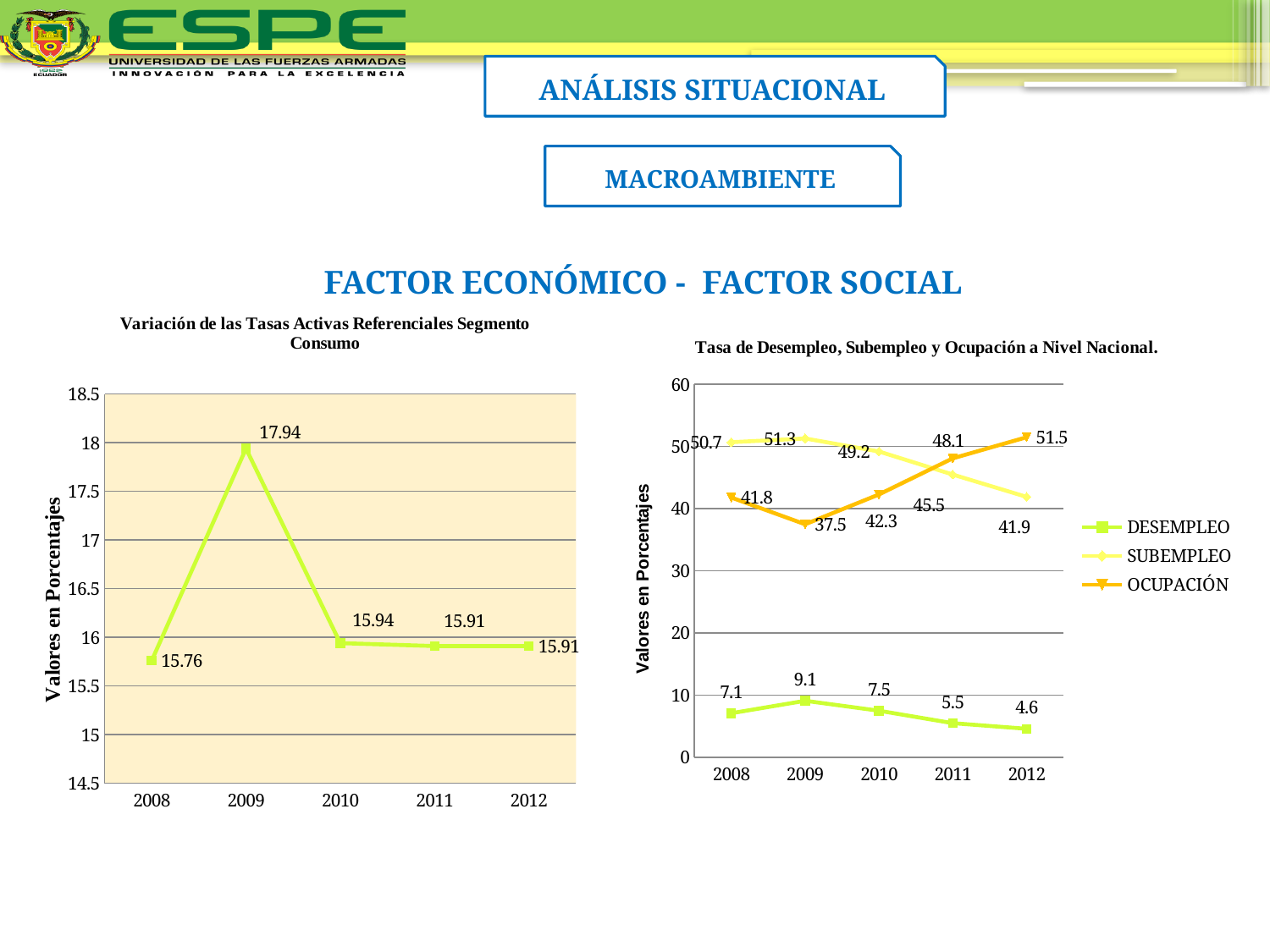
In the right chart (Tasa de Desempleo, Subempleo y Ocupación a Nivel Nacional), what is the difference between the SUBEMPLEO and OCUPACIÓN values in 2009? 13.8 What kind of chart is the left chart (Variación de las Tasas Activas Referenciales Segmento Consumo)? Line chart In the right chart (Tasa de Desempleo, Subempleo y Ocupación a Nivel Nacional), how many series does the legend list? 3 In the right chart (Tasa de Desempleo, Subempleo y Ocupación a Nivel Nacional), what is the OCUPACIÓN value for 2012? 51.5 In the right chart (Tasa de Desempleo, Subempleo y Ocupación a Nivel Nacional), does the OCUPACIÓN series rise or fall from 2009 to 2012? Rise In the left chart (Variación de las Tasas Activas Referenciales Segmento Consumo), how many years are plotted on the x axis? 5 In the right chart (Tasa de Desempleo, Subempleo y Ocupación a Nivel Nacional), which year has the lowest SUBEMPLEO value? 2012 In the left chart (Variación de las Tasas Activas Referenciales Segmento Consumo), which year has the lowest value? 2008 In the left chart (Variación de las Tasas Activas Referenciales Segmento Consumo), what is the difference between the 2009 value and the 2008 value? 2.18 In the right chart (Tasa de Desempleo, Subempleo y Ocupación a Nivel Nacional), which is larger in 2010: SUBEMPLEO or OCUPACIÓN? SUBEMPLEO In the left chart (Variación de las Tasas Activas Referenciales Segmento Consumo), what is the value for 2009? 17.94 In the right chart (Tasa de Desempleo, Subempleo y Ocupación a Nivel Nacional), what is the DESEMPLEO value for 2009? 9.1